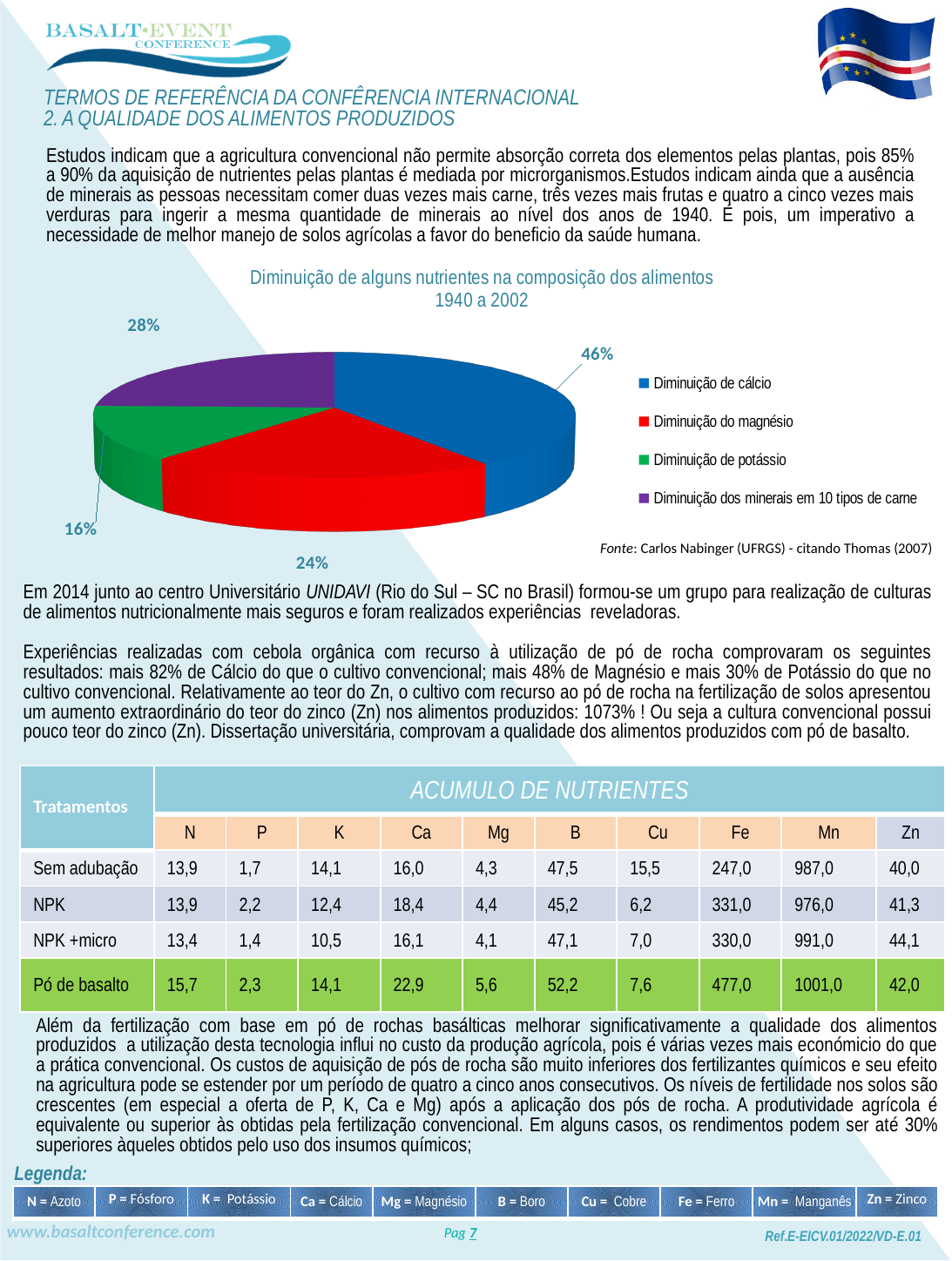
What is the title of the pie chart? Diminuição de alguns nutrientes na composição dos alimentos 1940 a 2002 What percentage is shown for 'Diminuição do magnésio' in the pie chart? 24% How many slices does the pie chart have? 4 What percentage is shown for 'Diminuição dos minerais em 10 tipos de carne' in the pie chart? 28% What percentage is shown for 'Diminuição de potássio' in the pie chart? 16% What percentage is shown for 'Diminuição de cálcio' in the pie chart? 46% Which category has the smallest slice in the pie chart? Diminuição de potássio Which colour represents 'Diminuição de potássio' in the pie chart? Green What kind of chart is shown on the slide? Pie chart Which category has the largest slice in the pie chart? Diminuição de cálcio How many entries does the legend of the pie chart list? 4 What is the difference between the percentages for 'Diminuição de cálcio' and 'Diminuição do magnésio'? 22 percentage points